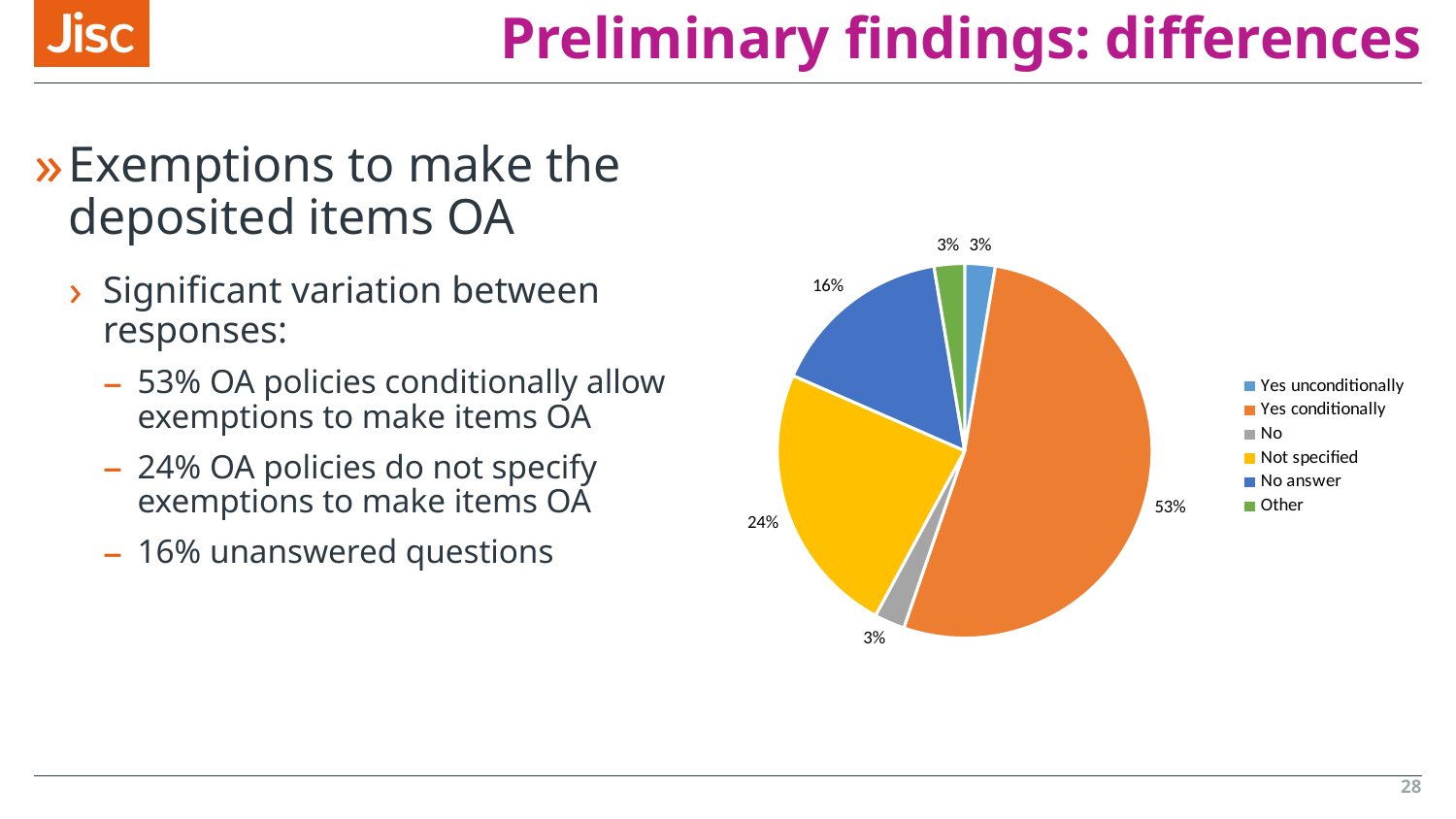
Which category has the largest slice of the pie? Yes conditionally What share of the pie does "No answer" represent? 16% Which colour represents "No answer" in the pie chart? Blue Which is larger, the slice for "No answer" or the slice for "Not specified"? Not specified What share of the pie does "Yes conditionally" represent? 53% What is the difference in percentage points between "Not specified" and "No answer"? 8 What share of the pie does "No" represent? 3% How many categories does the legend list? 6 What type of chart is shown on the slide? Pie chart What is the difference in percentage points between "Yes conditionally" and "Not specified"? 29 Which colour represents "Not specified" in the pie chart? Yellow